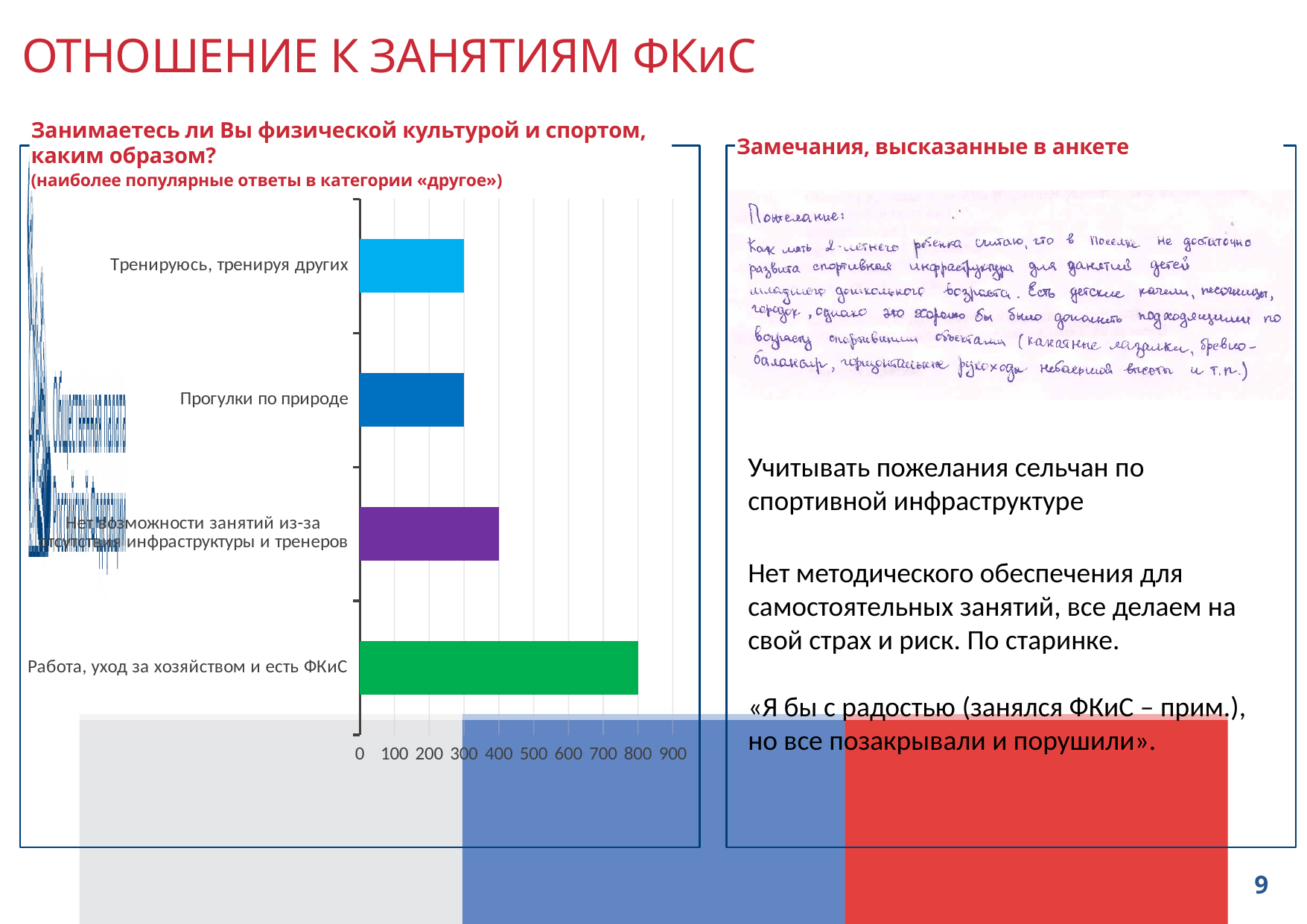
Is the value for "Тренируюсь, тренируя других" greater or less than 500? less What is the difference between the values for "Работа, уход за хозяйством и есть ФКиС" and "Нет возможности занятий из-за отсутствия инфраструктуры и тренеров"? 400 What is the value for "Работа, уход за хозяйством и есть ФКиС"? 800 What kind of chart is shown on the left of the slide? bar chart Is the value for "Работа, уход за хозяйством и есть ФКиС" greater or less than 500? greater What is the value for "Прогулки по природе"? 300 How many categories does the bar chart show? 4 Which category has the highest value in the bar chart? Работа, уход за хозяйством и есть ФКиС Which is larger: the value for "Работа, уход за хозяйством и есть ФКиС" or for "Прогулки по природе"? Работа, уход за хозяйством и есть ФКиС What colour is the bar for "Работа, уход за хозяйством и есть ФКиС"? green What is the value for "Нет возможности занятий из-за отсутствия инфраструктуры и тренеров"? 400 What is the value for "Тренируюсь, тренируя других"? 300